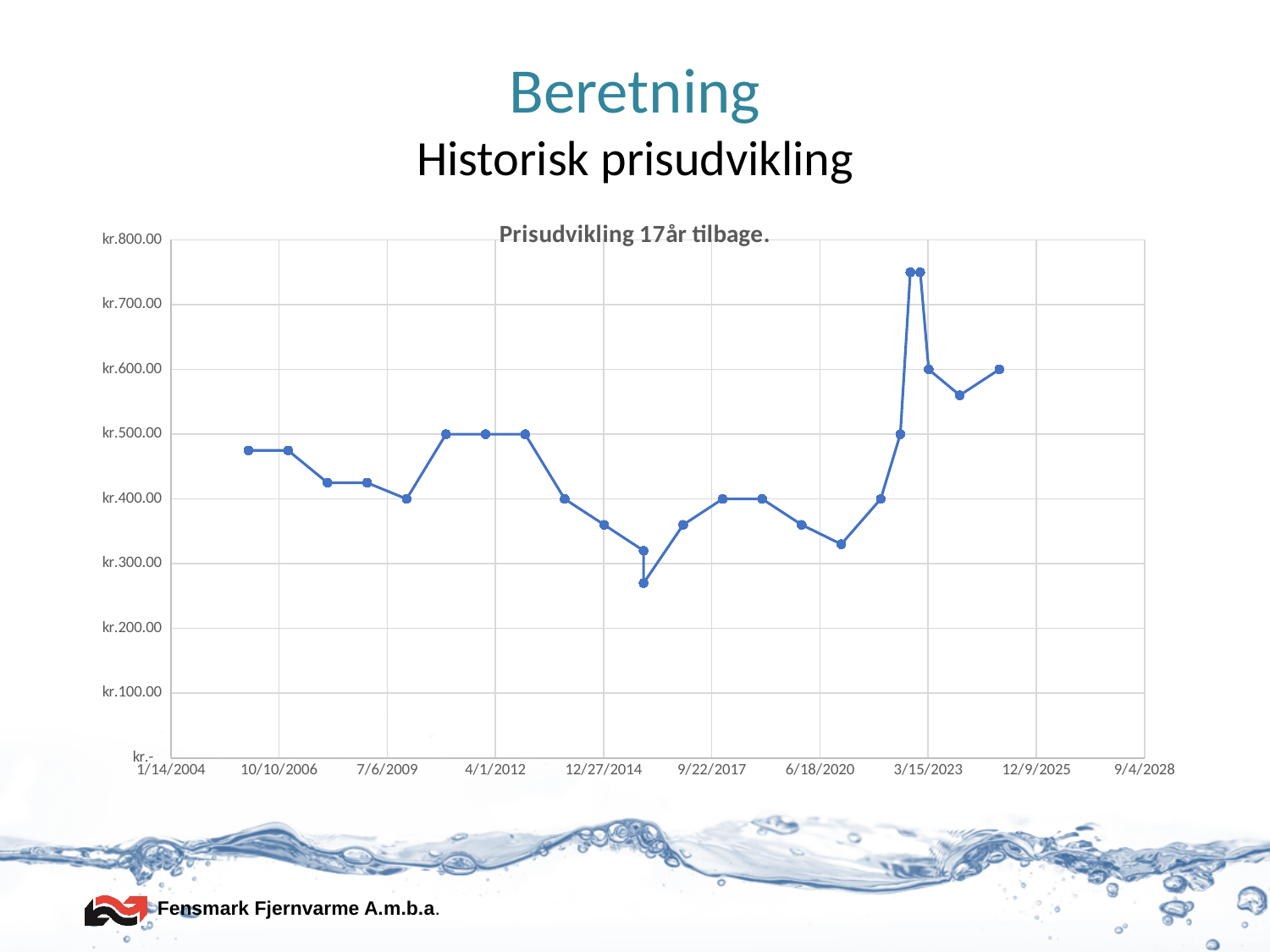
How many data series are plotted on the chart? 1 Do the values rise or fall between 6/18/2020 and 3/15/2023? rise What is the title of the chart? Prisudvikling 17år tilbage. Is the last plotted value (around 2025) greater or less than kr.500.00? greater Is the highest value plotted on the chart greater or less than kr.700.00? greater Do the values rise or fall between 4/1/2012 and 12/27/2014? fall What is the highest value shown on the vertical axis? kr.800.00 Is the peak value around 3/15/2023 larger or smaller than the value around 4/1/2012? larger What kind of chart is shown on the slide? line chart Is the lowest value plotted on the chart greater or less than kr.300.00? less